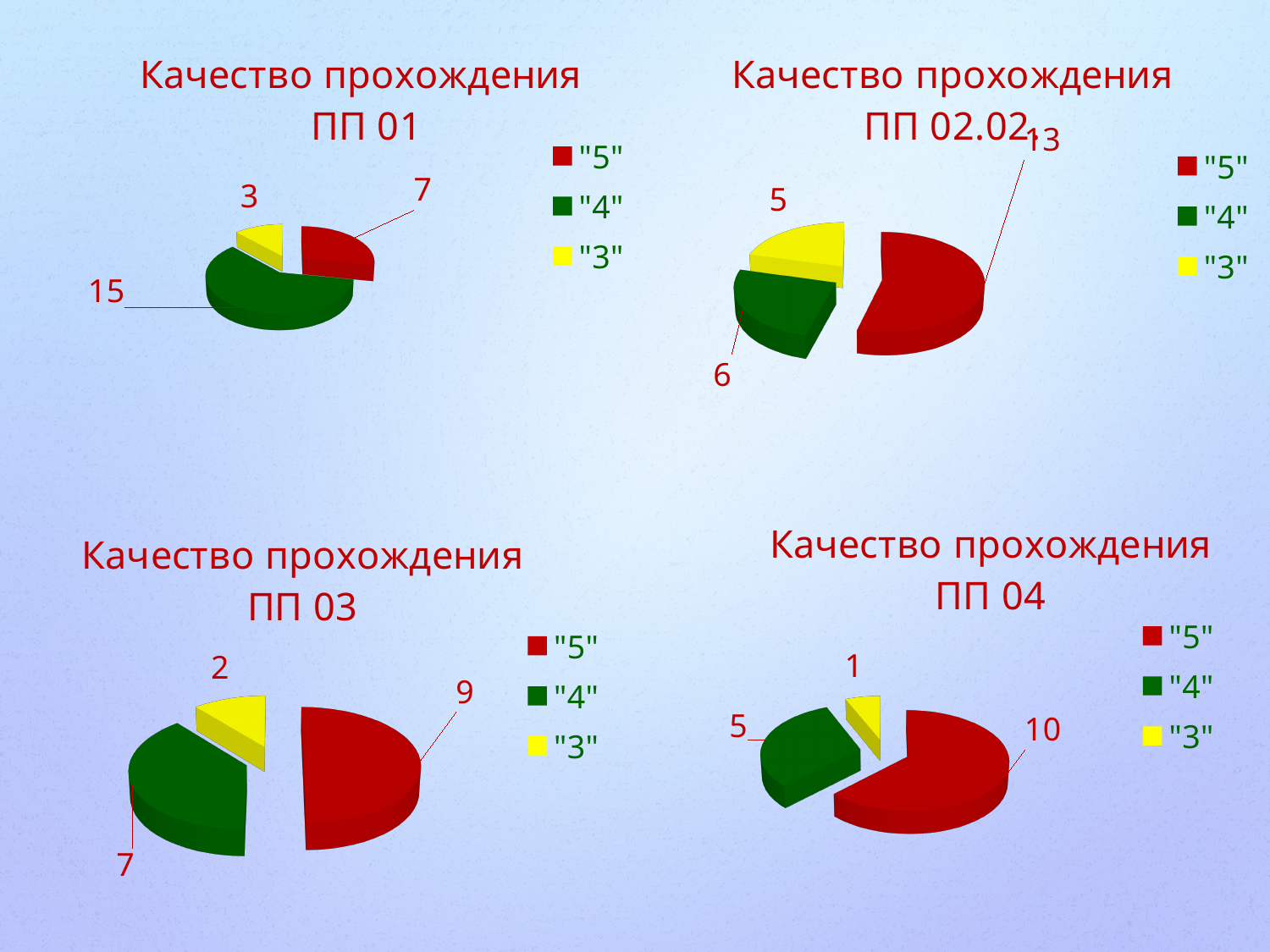
In the chart titled "Качество прохождения ПП 04", what is the value for "4"? 5 In the chart titled "Качество прохождения ПП 03", what is the value for "3"? 2 In the chart titled "Качество прохождения ПП 02.02", what is the difference between the values for "5" and "4"? 7 In the chart titled "Качество прохождения ПП 04", what share of the total does the "3" slice represent? 1/16 In the chart titled "Качество прохождения ПП 04", which category has the smallest slice? "3" In the chart titled "Качество прохождения ПП 01", which category has the largest slice? "4" What kind of chart is used for "Качество прохождения ПП 03"? Pie chart How many entries does the legend of the chart titled "Качество прохождения ПП 02.02" list? 3 In the chart titled "Качество прохождения ПП 02.02", what is the value for "5"? 13 In the chart titled "Качество прохождения ПП 01", what is the total of all slices? 25 In the chart titled "Качество прохождения ПП 01", what is the value for "4"? 15 In the chart titled "Качество прохождения ПП 03", which is larger, the value for "5" or the value for "4"? "5"